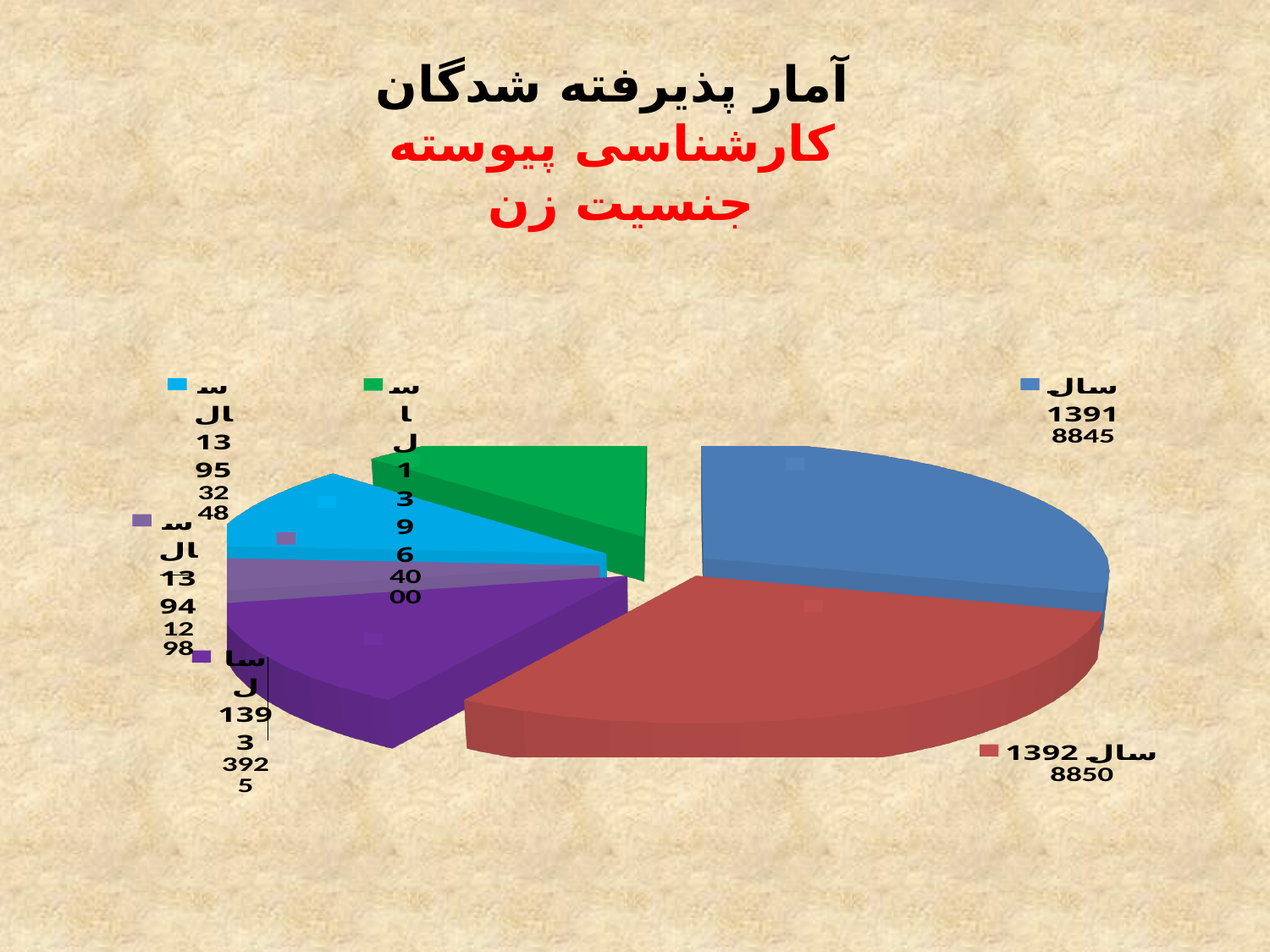
What is the value shown for سال 1392? 8850 What is the difference between the values for سال 1396 and سال 1395? 752 How many slices does the pie chart have? 6 Which year has the largest value in the pie chart? سال 1392 What type of chart is shown on the slide? pie chart Which is larger, the value for سال 1393 or the value for سال 1395? سال 1393 What is the value shown for سال 1395? 3248 What colour is the slice for سال 1392? red Which year has the smallest slice in the pie chart? سال 1394 What is the value shown for سال 1391? 8845 What is the value shown for سال 1396? 4000 What is the difference between the values for سال 1392 and سال 1391? 5